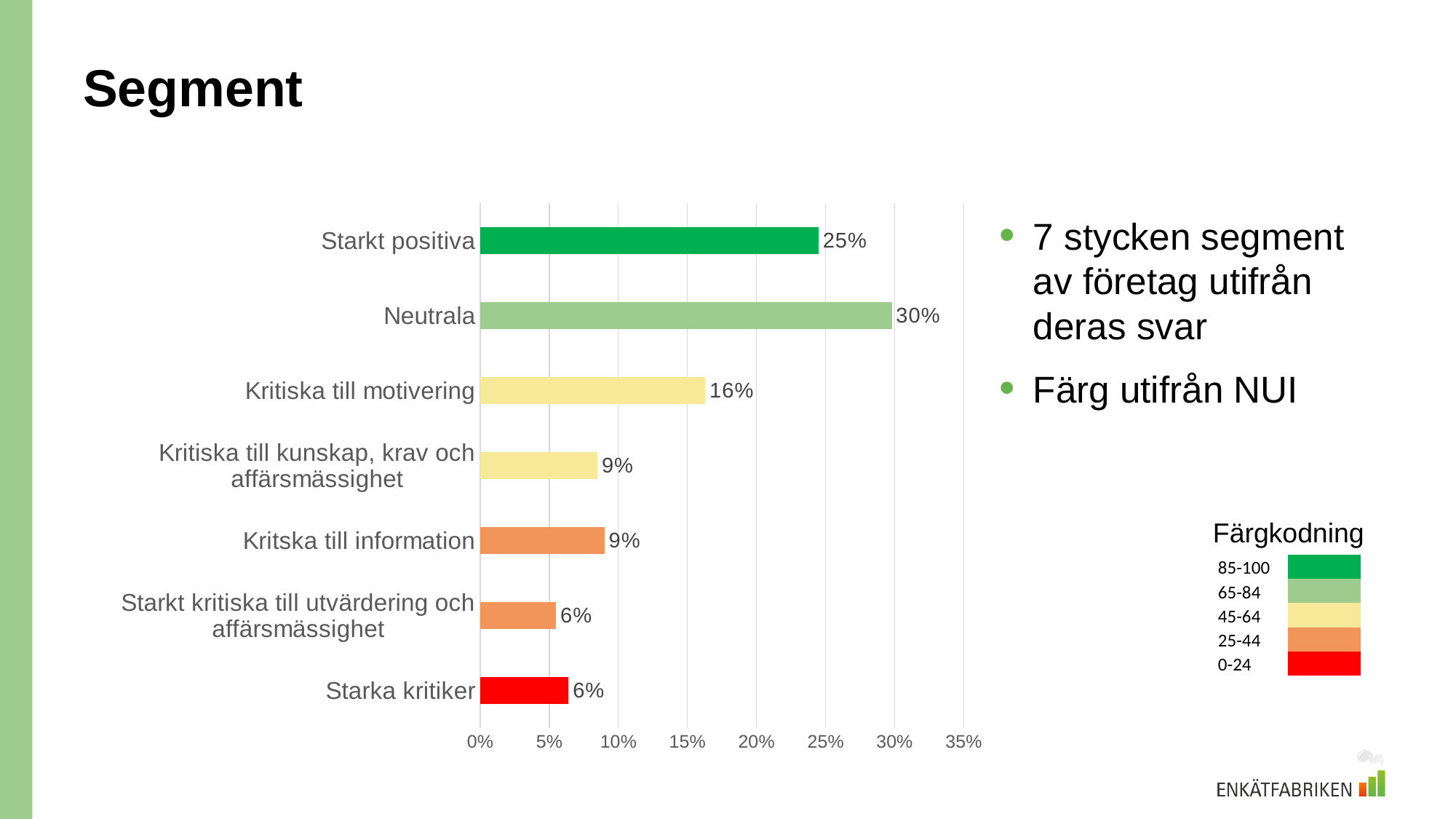
What is the value for Kritiska till motivering? 16% What colour is the bar for Starka kritiker? red What is the value for Starkt positiva? 25% Which is larger, the value for Starkt positiva or the value for Kritiska till motivering? Starkt positiva Which category has the highest value? Neutrala Is the value for Neutrala greater or less than 25%? greater What is the difference between the values for Kritiska till motivering and Starka kritiker? 10% What is the difference between the values for Neutrala and Starkt positiva? 5% What is the value for Neutrala? 30% What kind of chart is shown on the slide? bar chart What is the value for Starka kritiker? 6% How many categories are shown in the chart? 7